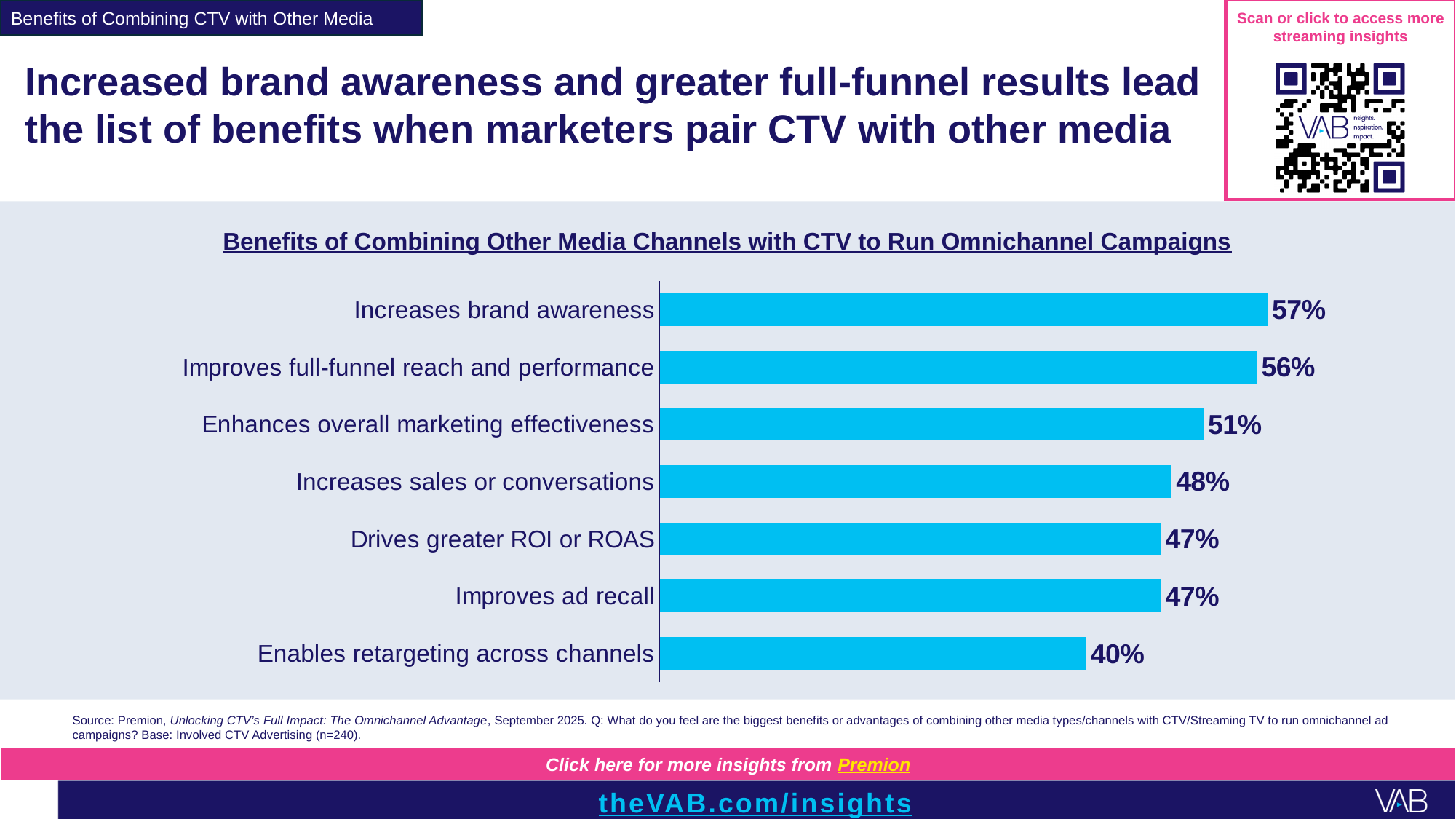
What percentage of respondents cited 'Increases brand awareness' as a benefit? 57% Which benefit has the highest value in the chart? Increases brand awareness What is the difference between 'Increases brand awareness' and 'Enables retargeting across channels'? 17 percentage points What is the title of the chart? Benefits of Combining Other Media Channels with CTV to Run Omnichannel Campaigns What is the difference between 'Improves full-funnel reach and performance' and 'Increases sales or conversations'? 8 percentage points Which benefit has the lowest value in the chart? Enables retargeting across channels What is the value for 'Enables retargeting across channels'? 40% How many benefits are shown in the chart? 7 What is the value for 'Enhances overall marketing effectiveness'? 51% What is the value for 'Drives greater ROI or ROAS'? 47% What type of chart is shown on the slide? Bar chart Which is larger: the value for 'Enhances overall marketing effectiveness' or the value for 'Improves ad recall'? Enhances overall marketing effectiveness